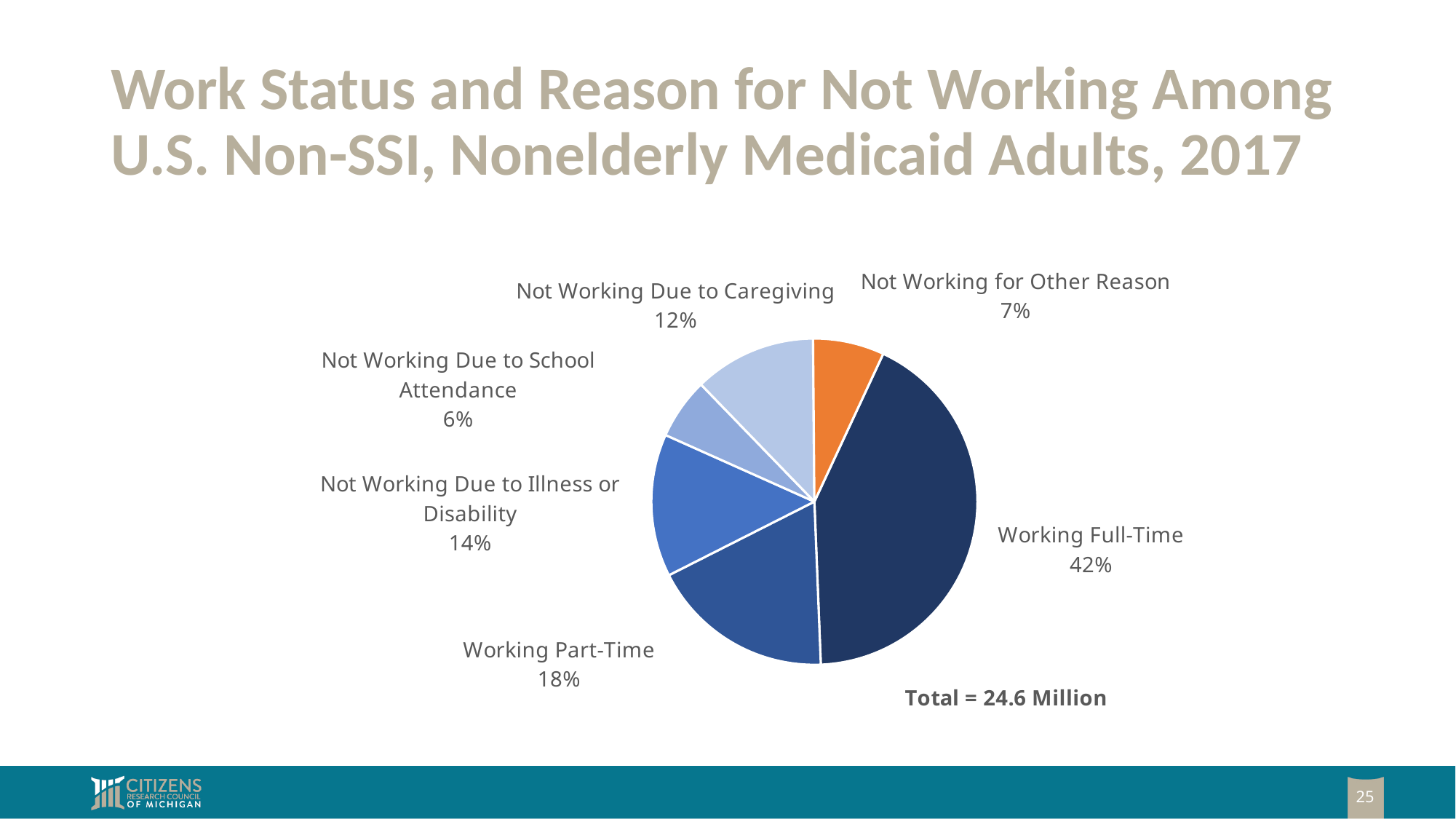
Which category has the largest slice of the pie? Working Full-Time What is the difference in percentage points between Working Full-Time and Working Part-Time? 24 What percentage is shown for Not Working for Other Reason? 7% What percentage is shown for Not Working Due to Illness or Disability? 14% Which category has the smallest slice of the pie? Not Working Due to School Attendance What kind of chart is shown on the slide? pie chart How many categories are shown in the pie chart? 6 What share of the pie is Working Full-Time? 42% Which is larger, Not Working Due to Caregiving or Not Working Due to Illness or Disability? Not Working Due to Illness or Disability What percentage is shown for Not Working Due to Caregiving? 12% What total is stated below the pie chart? Total = 24.6 Million Which slice of the pie is colored orange? Not Working for Other Reason